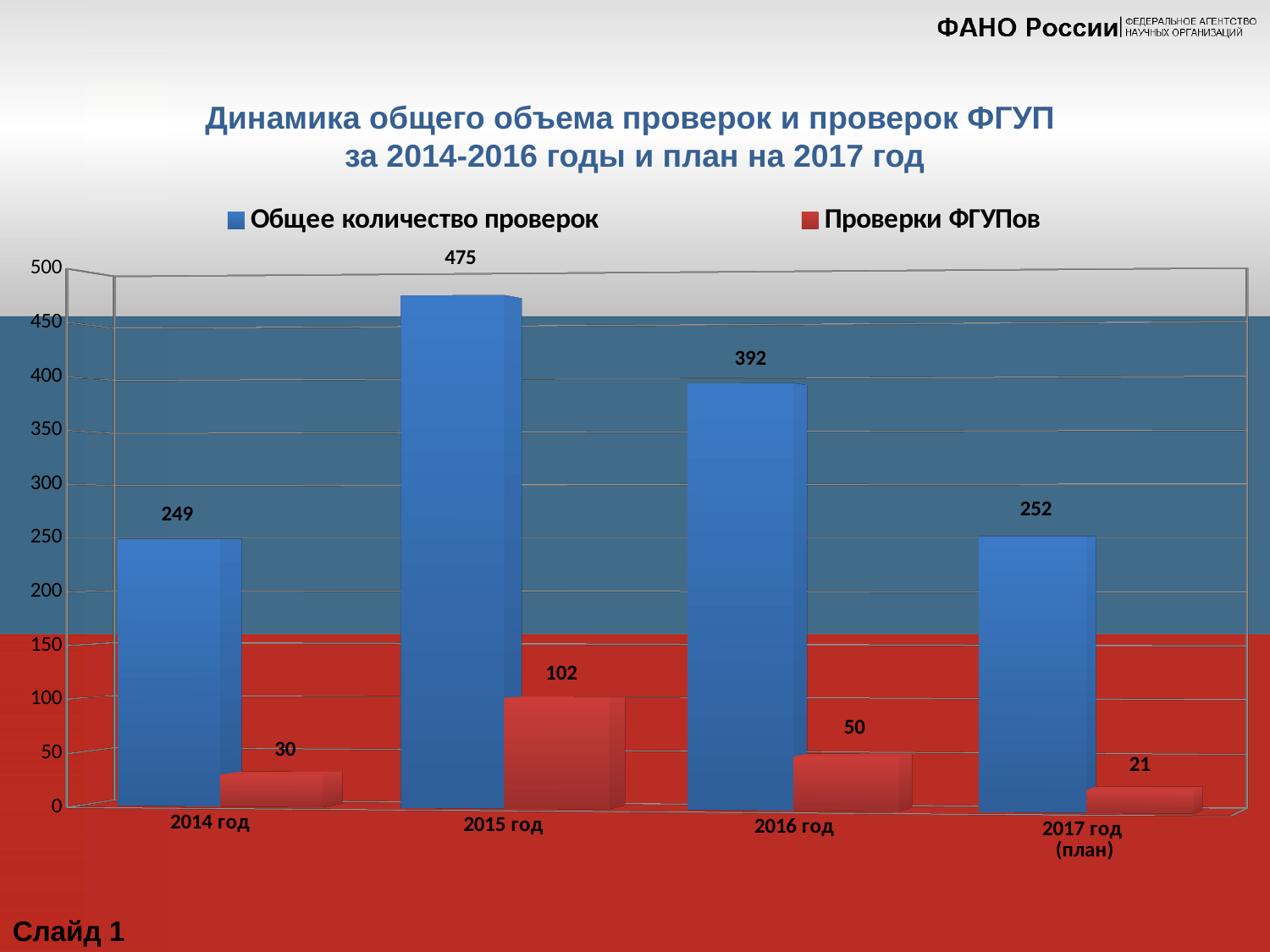
What is the value of "Общее количество проверок" for 2015 год? 475 How many series does the legend list? 2 What is the value of "Общее количество проверок" for 2017 год (план)? 252 How many year categories are shown on the x axis? 4 Which year has the highest value for "Общее количество проверок"? 2015 год Which is larger: "Общее количество проверок" for 2014 год or for 2017 год (план)? 2017 год (план) Which series is shown in red in the legend? Проверки ФГУПов What is the value of "Проверки ФГУПов" for 2016 год? 50 What is the difference between "Проверки ФГУПов" in 2015 год and 2014 год? 72 What is the difference between "Общее количество проверок" in 2015 год and 2016 год? 83 Which year has the lowest value for "Проверки ФГУПов"? 2017 год (план) What kind of chart is shown on the slide? Bar chart